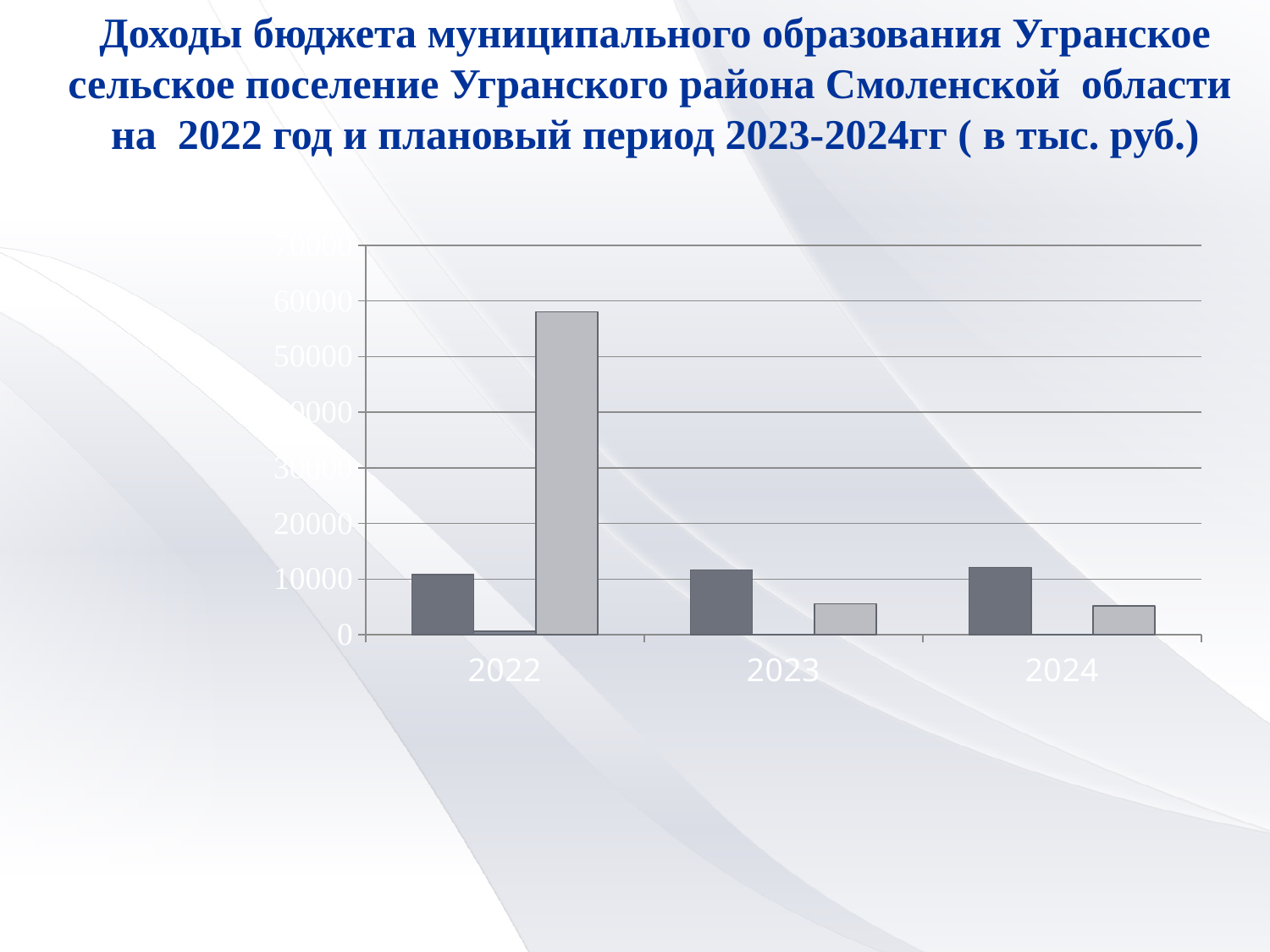
In which year does the chart have its tallest bar? 2022 Does the light grey bar rise or fall from 2022 to 2024? falls What is the highest value shown on the vertical axis of the chart? 70000 How many years are shown on the x axis of the chart? 3 Is the value of the tallest light grey bar for 2022 greater or less than 60000? less Is the value of the tallest light grey bar for 2022 greater or less than 50000? greater Is the value of the light grey bar for 2023 greater or less than 10000? less Which years are shown on the x axis of the chart? 2022, 2023, 2024 What kind of chart is shown on the slide? bar chart Which is larger: the dark grey bar for 2023 or the light grey bar for 2023? the dark grey bar